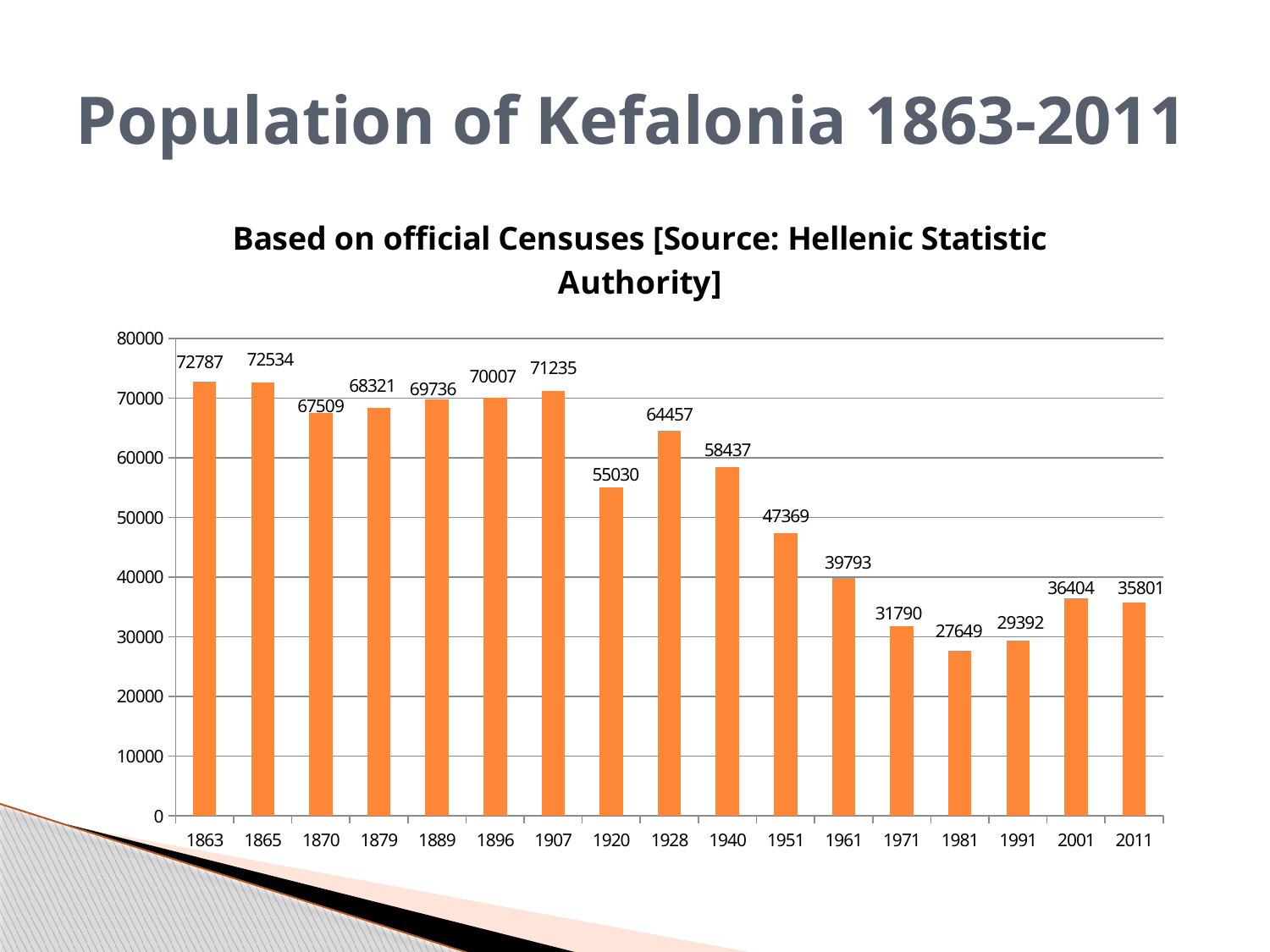
Overall, do the values rise or fall from 1863 to 2011? fall How many census years are shown on the x axis? 17 What kind of chart is this? bar chart What was the population in 2011? 35801 What is the difference between the population in 1863 and in 2011? 36986 Which census year has the lowest population? 1981 Which year had a larger population, 1991 or 2001? 2001 By how much did the population fall between 1907 and 1920? 16205 Is the value for 1940 greater or less than 60000? less Which census year has the highest population? 1863 What was the population of Kefalonia in 1907? 71235 What value is shown for the year 1951? 47369